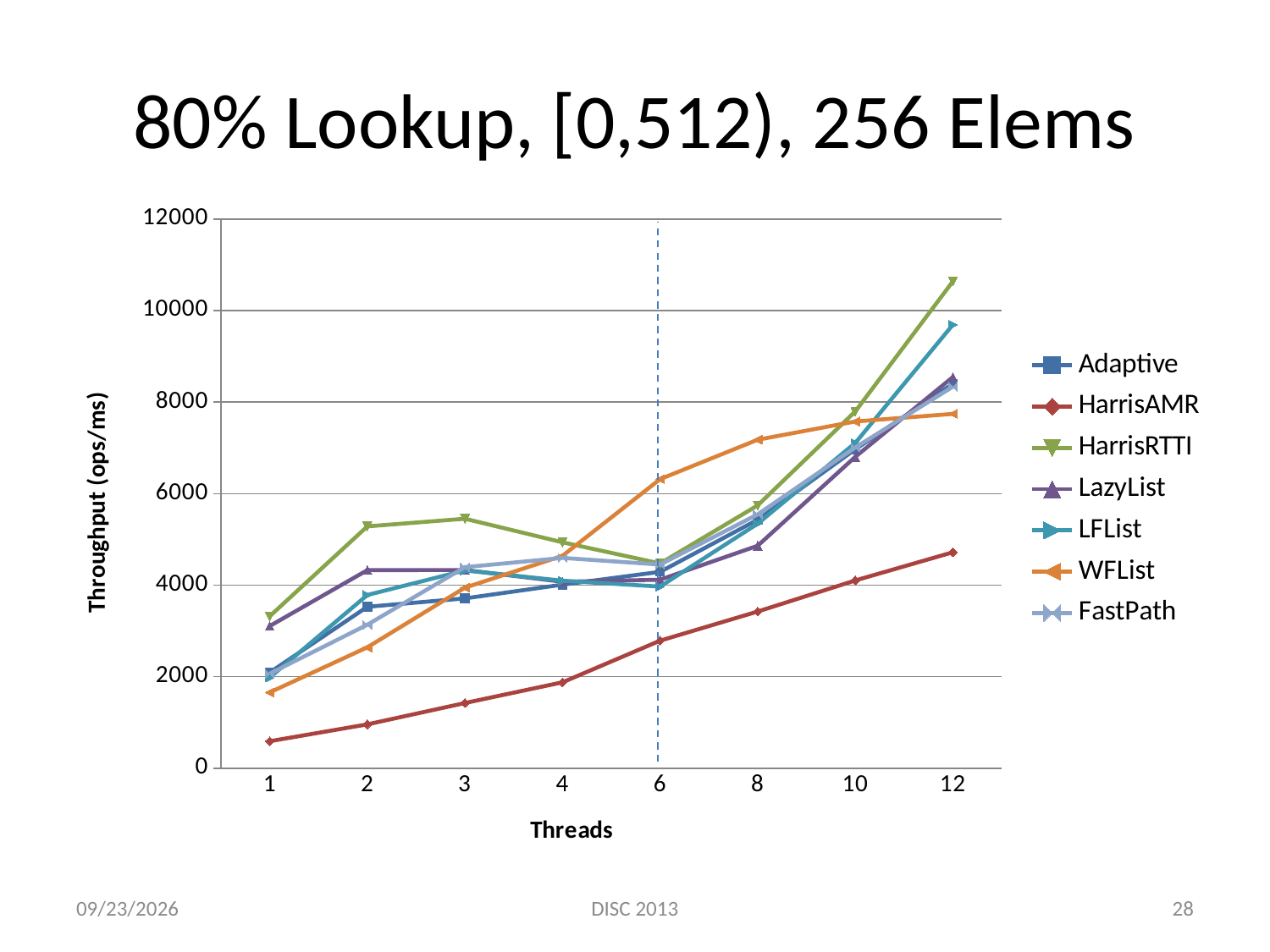
Which series has the lowest throughput at 12 threads? HarrisAMR Is the value for WFList at 1 thread greater or less than 2000? less Does the throughput of HarrisAMR rise or fall as the number of threads increases? rise What is the label of the y axis? Throughput (ops/ms) Is the value for HarrisRTTI at 12 threads greater or less than 10000? greater At 8 threads, which is larger: WFList or LazyList? WFList Is the value for HarrisAMR at 12 threads greater or less than 6000? less Which series has the highest throughput at 12 threads? HarrisRTTI Which series has the highest throughput at 8 threads? WFList How many series does the legend list? 7 What kind of chart is shown on the slide? line chart How many thread counts are plotted along the x axis? 8